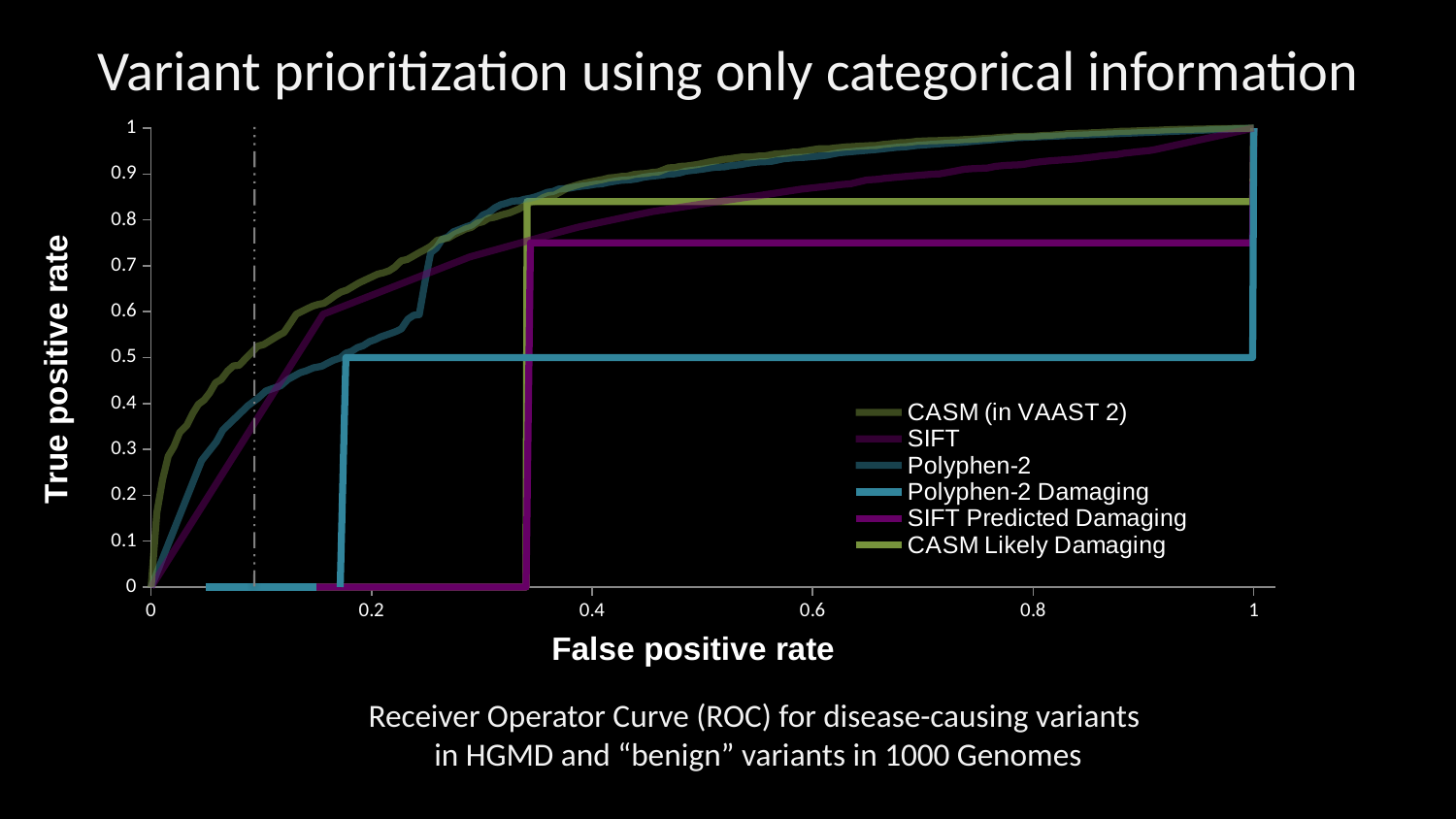
What is the title of the slide containing the chart? Variant prioritization using only categorical information Is the plateau value of the SIFT Predicted Damaging line greater or less than 0.8? less Do the true positive rates of the CASM (in VAAST 2) curve rise or fall as the false positive rate increases? rise Is the plateau value of the CASM Likely Damaging line greater or less than 0.8? greater Which plateau is higher: CASM Likely Damaging or Polyphen-2 Damaging? CASM Likely Damaging Is the plateau value of the SIFT Predicted Damaging line greater or less than 0.7? greater Which of the three step-shaped lines reaches its plateau at the lowest false positive rate? Polyphen-2 Damaging How many series does the legend list? 6 What kind of chart is shown on the slide? line chart At a false positive rate of 0.2, which curve has the higher true positive rate: CASM (in VAAST 2) or Polyphen-2? CASM (in VAAST 2) What is the label of the x axis? False positive rate